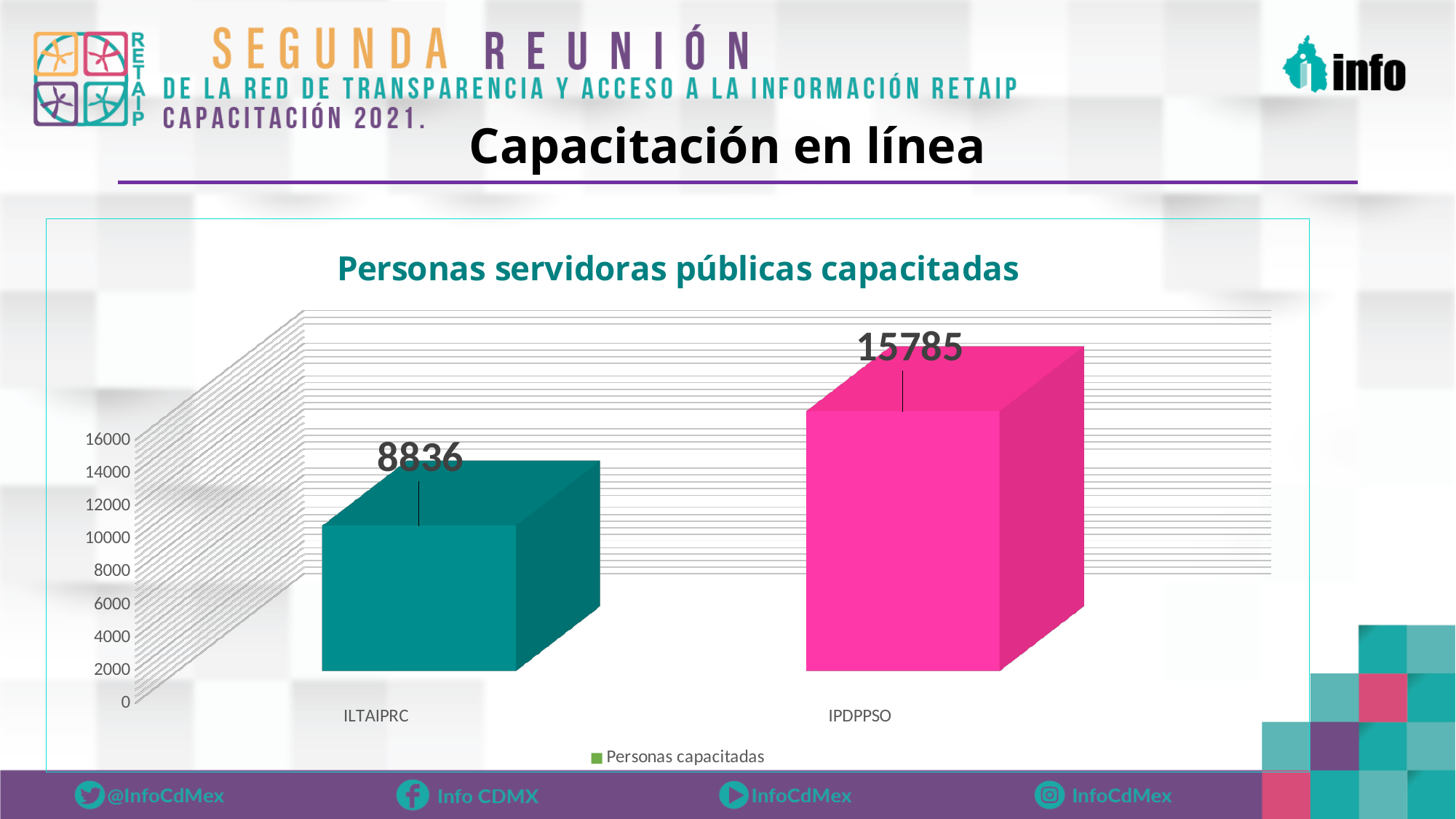
How many categories are shown in the chart? 2 Which is larger, the value for ILTAIPRC or the value for IPDPPSO? IPDPPSO What is the difference between the values for IPDPPSO and ILTAIPRC? 6949 Which category has the highest value? IPDPPSO What is the value for ILTAIPRC? 8836 What is the title of the chart? Personas servidoras públicas capacitadas Which category has the lowest value? ILTAIPRC Is the value for ILTAIPRC greater or less than 10000? less Is the value for IPDPPSO greater or less than 14000? greater What is the value for IPDPPSO? 15785 How many series does the legend list? 1 What kind of chart is shown on the slide? bar chart